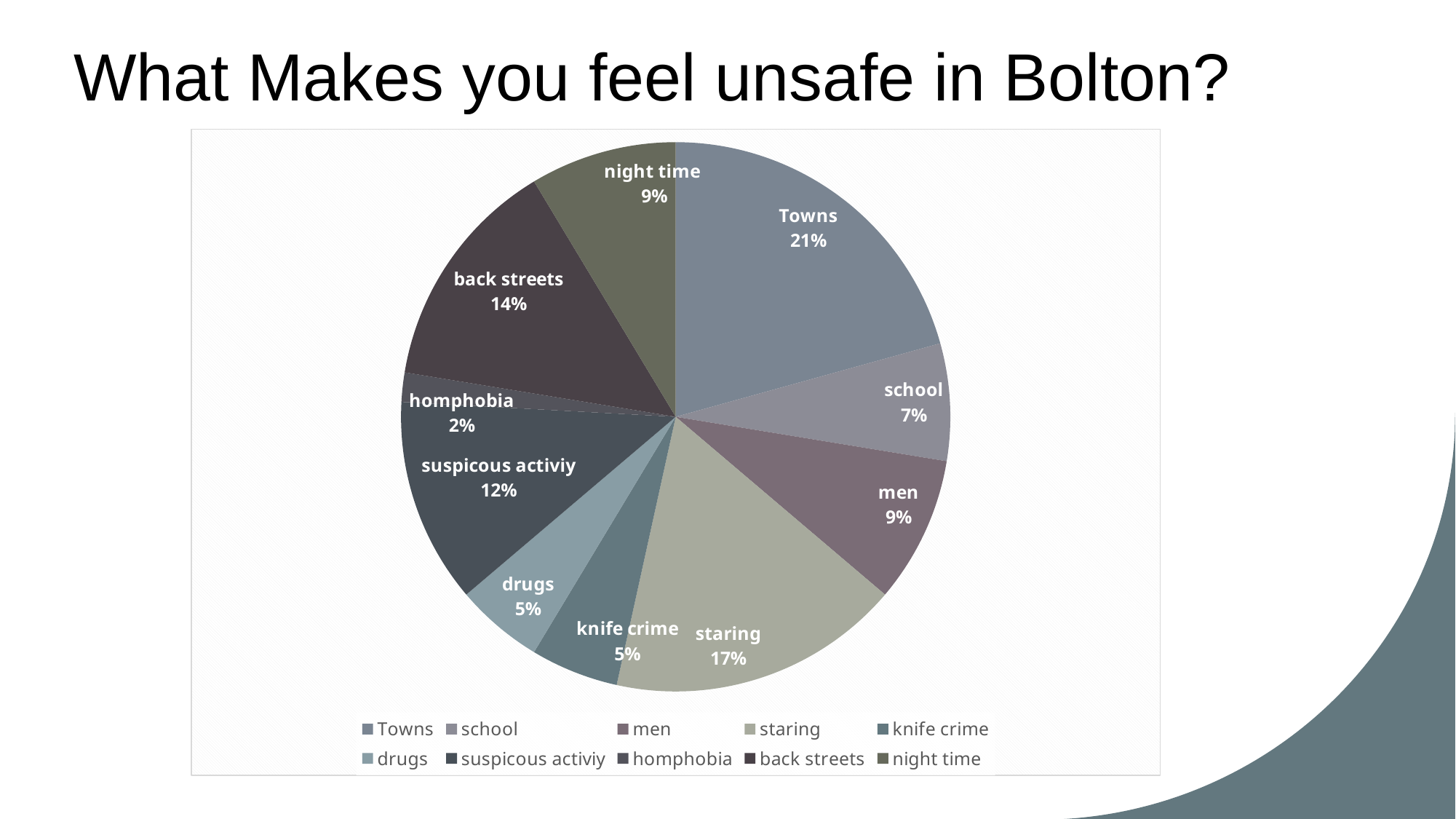
What percentage is shown for staring? 17% Which is larger, the slice for suspicous activiy or the slice for school? suspicous activiy What percentage is shown for night time? 9% What is the title of the slide containing the chart? What Makes you feel unsafe in Bolton? What kind of chart is shown on the slide? pie chart What is the difference in percentage points between back streets and drugs? 9 What is the difference in percentage points between Towns and staring? 4 Which category has the smallest slice of the pie? homphobia What percentage is shown for back streets? 14% Which category has the largest slice of the pie? Towns What share of the pie does Towns account for? 21% How many categories are shown in the pie chart? 10